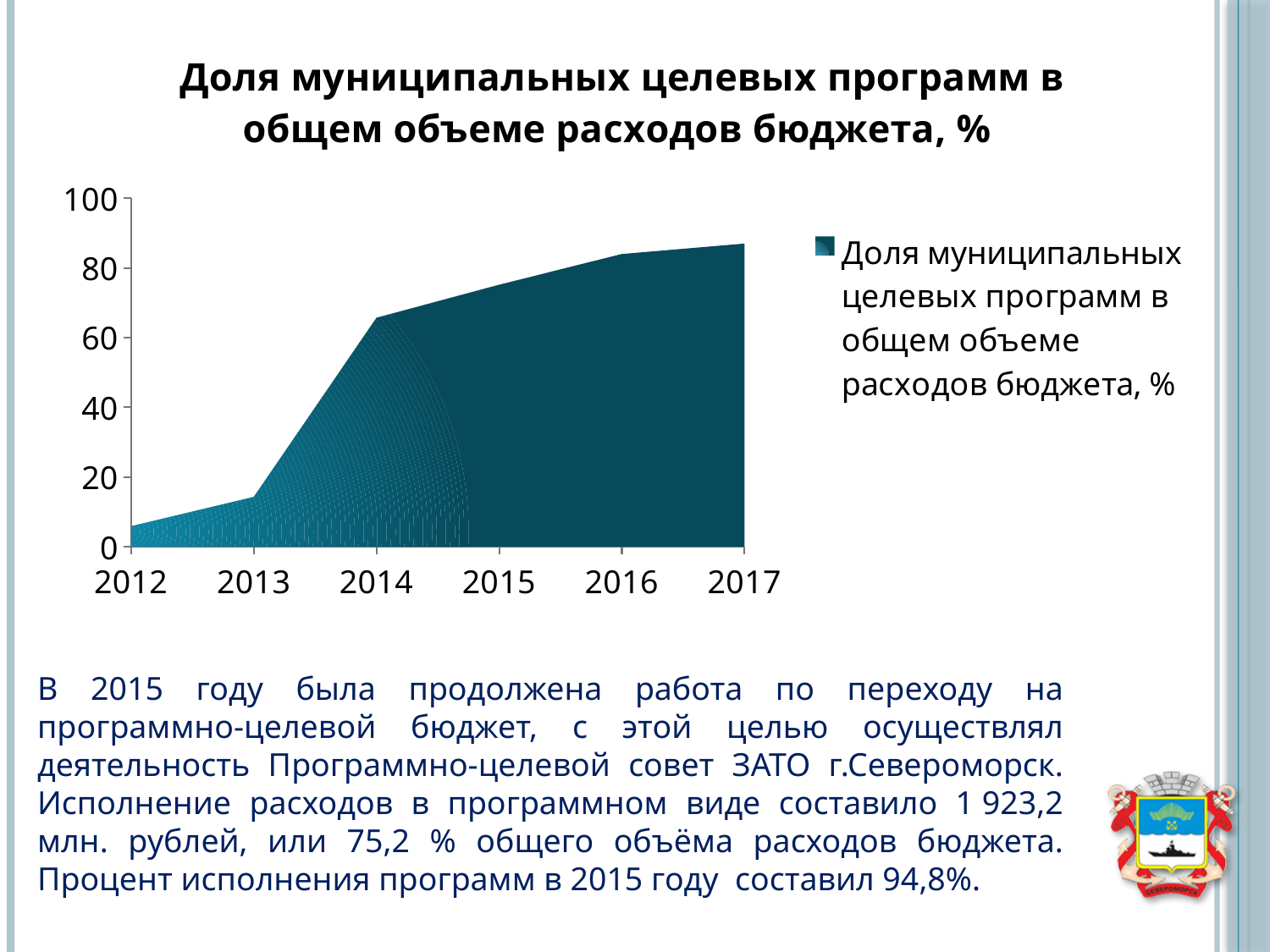
Do the values rise or fall from 2012 to 2017? rise Is the value for 2014 greater or less than 60? greater Is the value for 2017 greater or less than 80? greater How many years are shown on the x axis of the chart? 6 Is the value for 2012 greater or less than 20? less What kind of chart is shown on the slide? area chart What is the first year shown on the x axis of the chart? 2012 Which year has the lowest value in the chart? 2012 Which year has the larger value, 2013 or 2014? 2014 Which year has the highest value in the chart? 2017 How many series does the chart legend list? 1 What is the title of the chart? Доля муниципальных целевых программ в общем объеме расходов бюджета, %